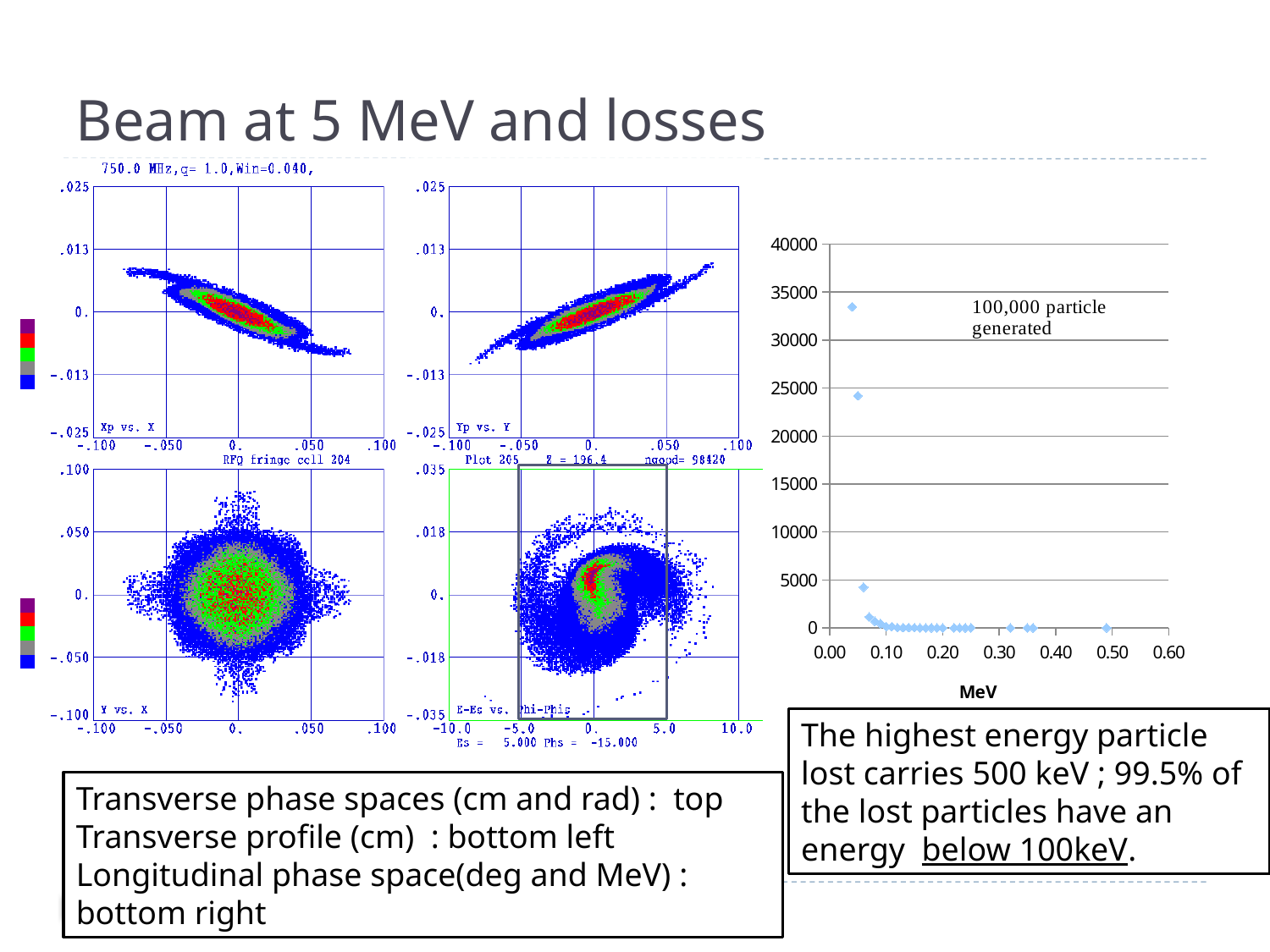
In the chart on the right, do the plotted values rise or fall as the energy in MeV increases? fall In the chart on the right, is the value of the second-highest point greater or less than 20000? greater In the chart on the right, what is the title of the horizontal axis? MeV What kind of chart is the chart on the right of the slide with the MeV axis? scatter chart In the chart on the right, what is the largest tick value shown on the horizontal axis? 0.60 In the chart on the right, is the value of the highest point greater or less than 30000? greater In the chart on the right, what text annotation is printed inside the plot area? 100,000 particle generated In the chart on the right, is the point near 0.50 MeV greater or less than 5000? less In the chart on the right, does the highest point occur at the low-energy end or the high-energy end of the MeV axis? low-energy end